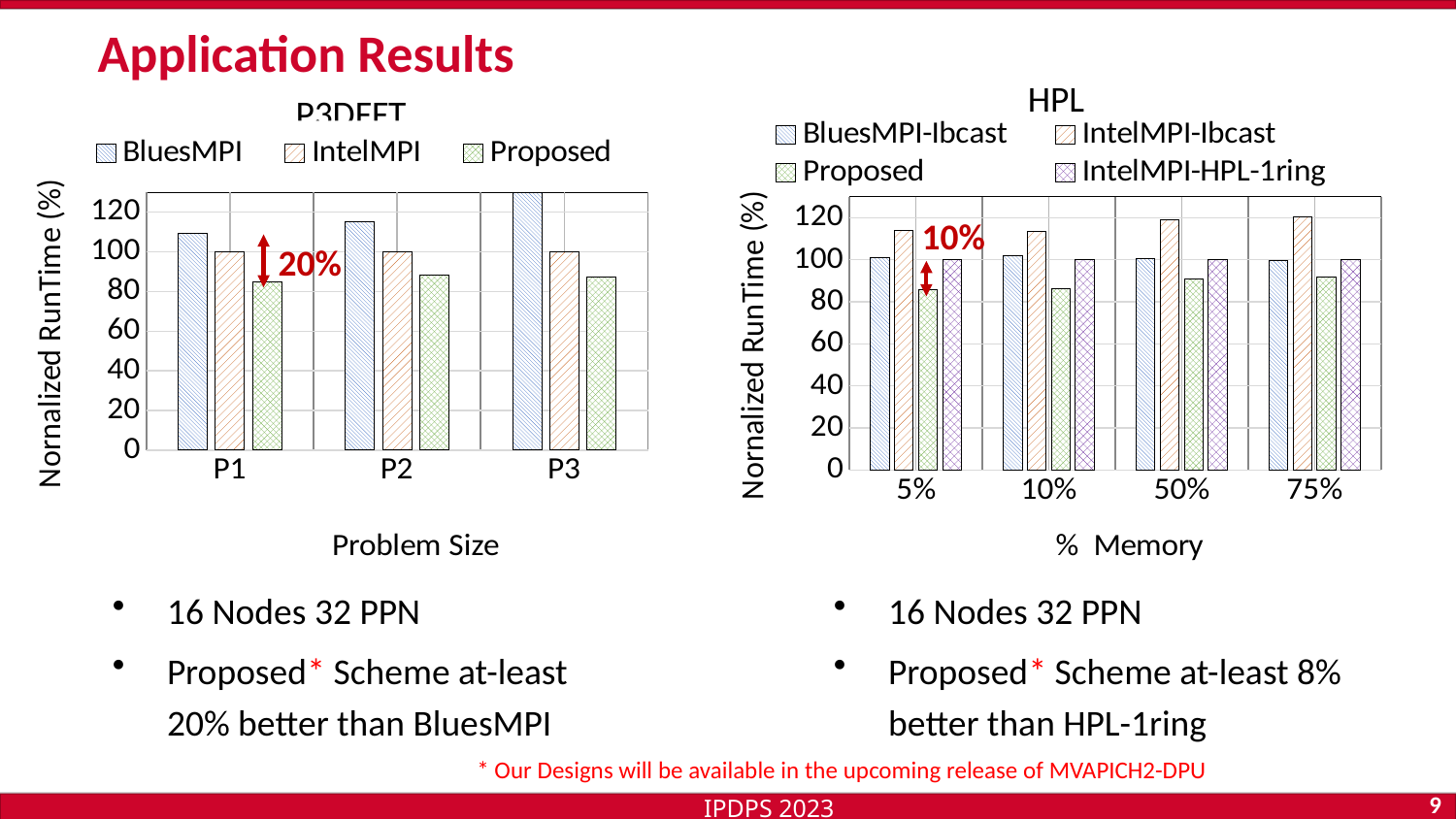
In the P3DFFT chart at P1, which is larger: BluesMPI or Proposed? BluesMPI How many series does the legend of the HPL chart list? 4 How many % Memory categories are shown on the x axis of the HPL chart? 4 How many series does the legend of the P3DFFT chart list? 3 What kind of chart is the P3DFFT chart on the left? bar chart How many problem sizes are shown on the x axis of the P3DFFT chart? 3 In the P3DFFT chart, which problem size has the highest BluesMPI value? P3 In the HPL chart, which series has the lowest value at 5%? Proposed In the P3DFFT chart, is the value for BluesMPI at P3 greater or less than 120? greater In the HPL chart, is the value for IntelMPI-Ibcast at 75% greater or less than 100? greater In the P3DFFT chart, is the value for Proposed at P1 greater or less than 100? less What is the x-axis label of the HPL chart? % Memory